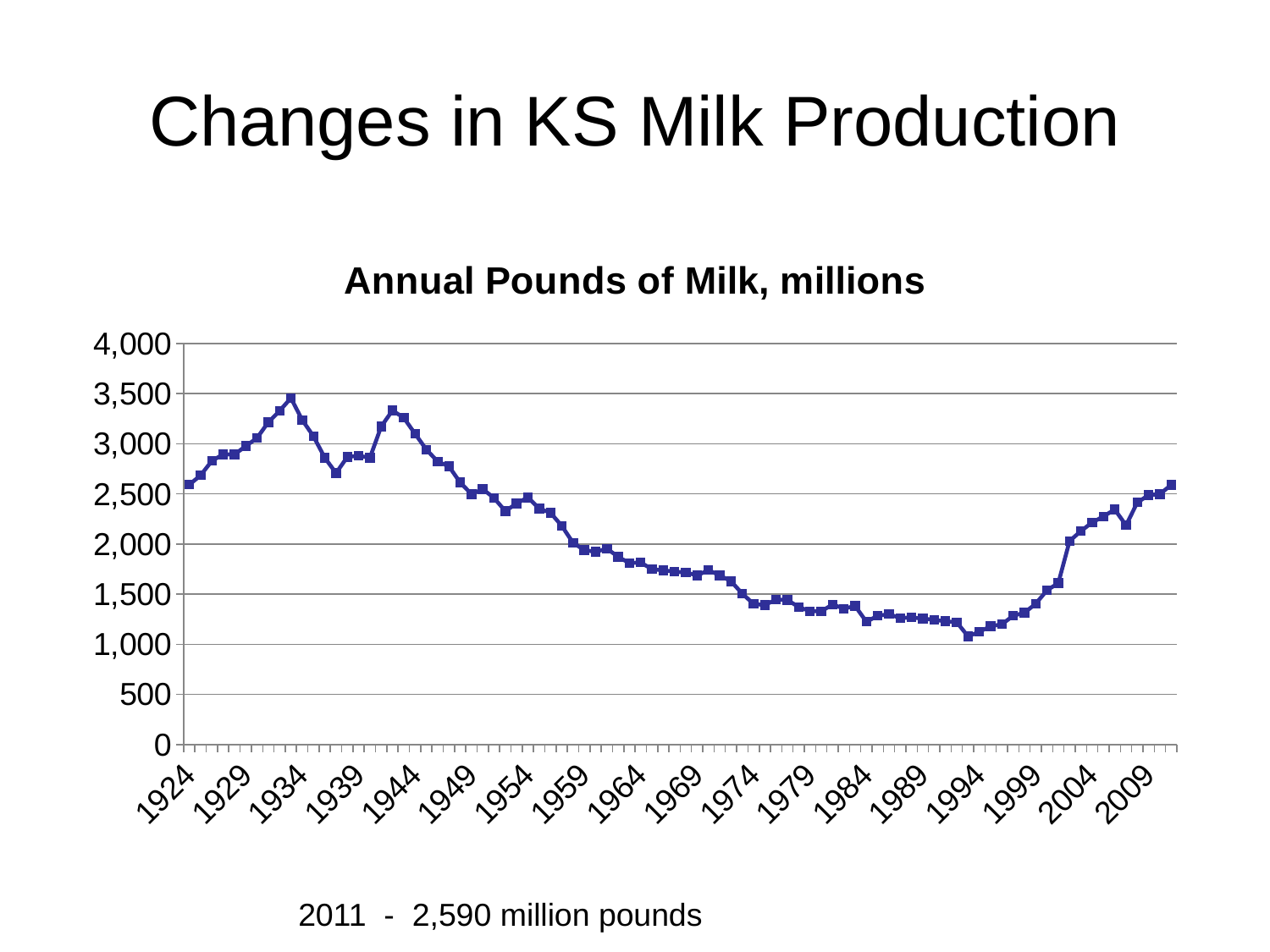
Is the value for 1964 greater or less than 2,000? less What kind of chart is shown on the slide? line chart Around which labelled year does the line reach its highest point? 1934 What is the title of the chart? Annual Pounds of Milk, millions What value does the slide give for milk production in 2011? 2,590 million pounds Around which labelled year does the line reach its lowest point? 1994 Which year has the larger value, 1944 or 1964? 1944 Is the value for 2004 greater or less than 2,000? greater Does the line generally rise or fall between 1944 and 1994? fall Is the value for 1994 greater or less than 1,500? less